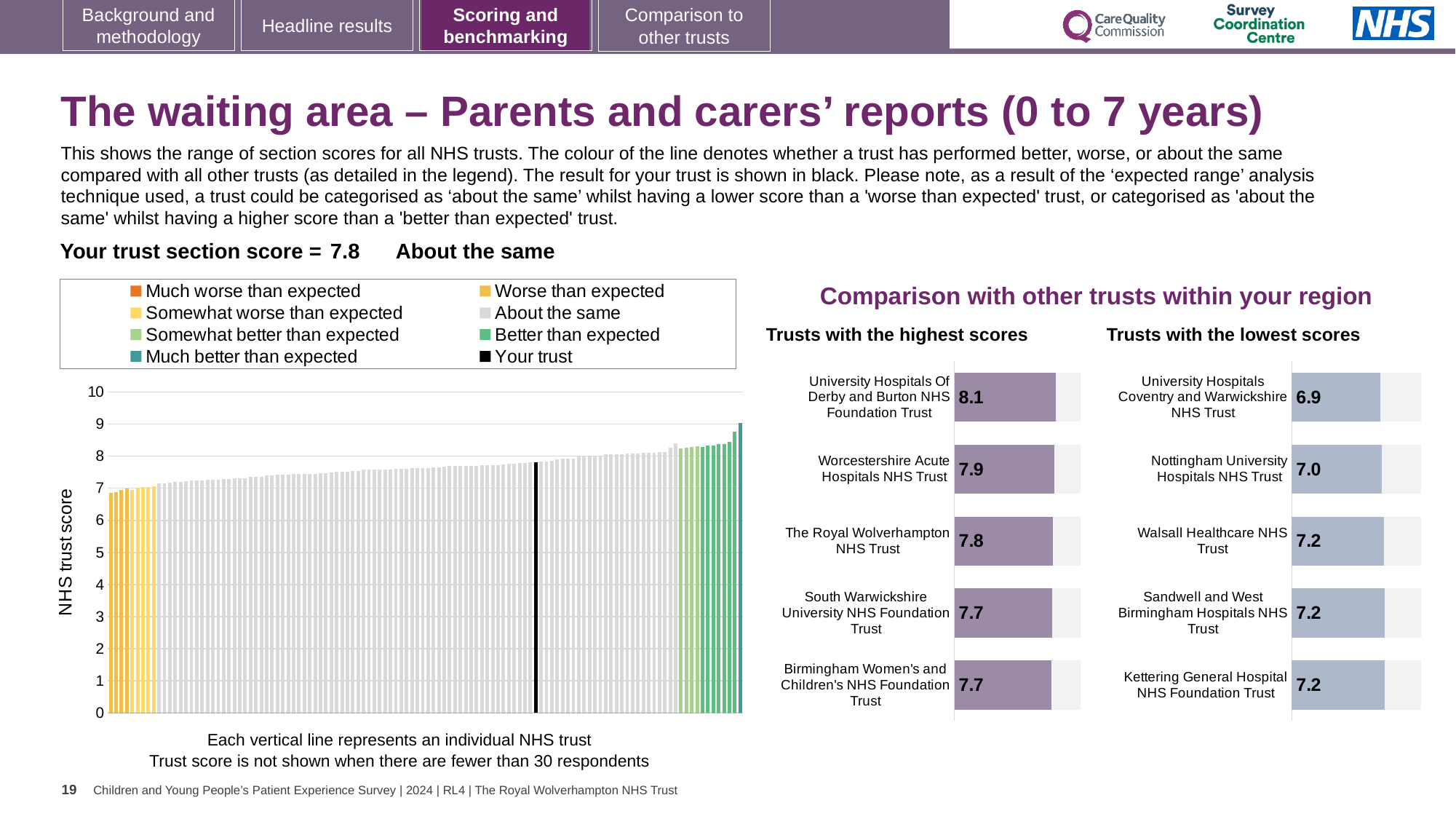
What kind of chart is the large chart on the left showing all NHS trusts? bar chart How many entries does the legend above the large chart on the left list? 8 In the 'Trusts with the lowest scores' chart, how many trusts are shown? 5 In the 'Trusts with the lowest scores' chart, what is the difference between the scores of Walsall Healthcare NHS Trust and University Hospitals Coventry and Warwickshire NHS Trust? 0.3 In the 'Trusts with the highest scores' chart, which has the higher score: Worcestershire Acute Hospitals NHS Trust or The Royal Wolverhampton NHS Trust? Worcestershire Acute Hospitals NHS Trust In the large chart on the left showing all NHS trusts, do the values rise or fall from left to right? rise In the 'Trusts with the lowest scores' chart, what is the score for Nottingham University Hospitals NHS Trust? 7.0 In the large chart on the left showing all NHS trusts, is the value for the black bar (your trust) greater or less than 7? greater In the 'Trusts with the lowest scores' chart, which trust has the lowest score? University Hospitals Coventry and Warwickshire NHS Trust In the 'Trusts with the highest scores' chart, what is the difference between the scores of University Hospitals Of Derby and Burton NHS Foundation Trust and Worcestershire Acute Hospitals NHS Trust? 0.2 In the 'Trusts with the highest scores' chart, what is the score for University Hospitals Of Derby and Burton NHS Foundation Trust? 8.1 In the 'Trusts with the highest scores' chart, which trust has the highest score? University Hospitals Of Derby and Burton NHS Foundation Trust